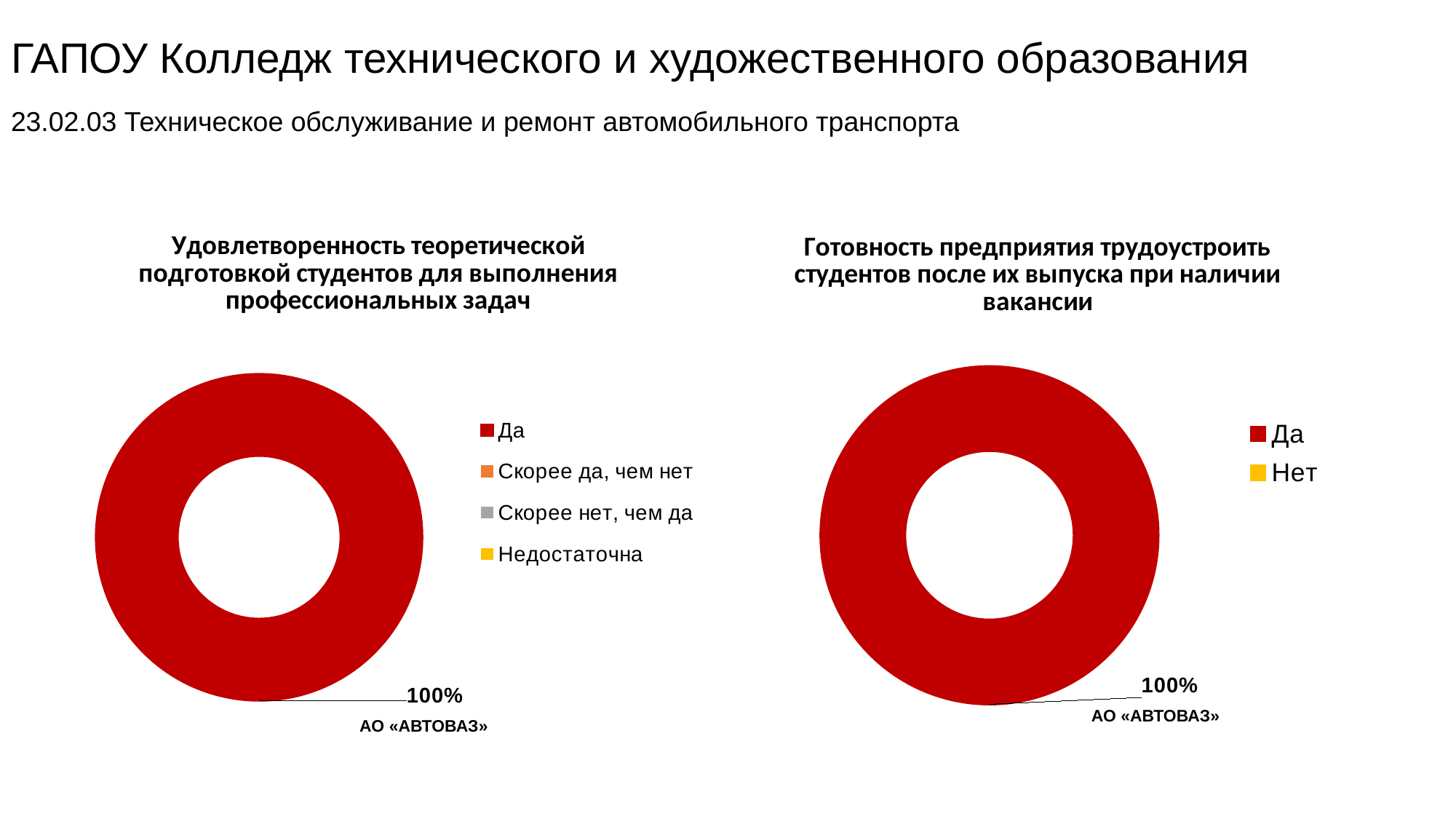
Which enterprise is named below the data label in the right chart (Готовность предприятия трудоустроить студентов)? АО «АВТОВАЗ» In the left chart (Удовлетворенность теоретической подготовкой студентов), what is the data label shown next to the ring? 100% In the left chart (Удовлетворенность теоретической подготовкой студентов), which category has the largest share? Да How many entries does the legend of the right chart (Готовность предприятия трудоустроить студентов) list? 2 What kind of chart is the left chart, titled "Удовлетворенность теоретической подготовкой студентов для выполнения профессиональных задач"? Doughnut (pie) chart How many entries does the legend of the left chart (Удовлетворенность теоретической подготовкой студентов) list? 4 In the right chart (Готовность предприятия трудоустроить студентов), what share of the ring does the "Да" slice take? 100% In the right chart (Готовность предприятия трудоустроить студентов), what colour does the legend assign to "Нет"? Yellow In the right chart (Готовность предприятия трудоустроить студентов), which category has the largest share? Да In the right chart (Готовность предприятия трудоустроить студентов), which is larger, the share for "Да" or the share for "Нет"? Да What kind of chart is the right chart, titled "Готовность предприятия трудоустроить студентов после их выпуска при наличии вакансии"? Doughnut (pie) chart In the left chart (Удовлетворенность теоретической подготовкой студентов), what share of the ring does the "Да" slice take? 100%